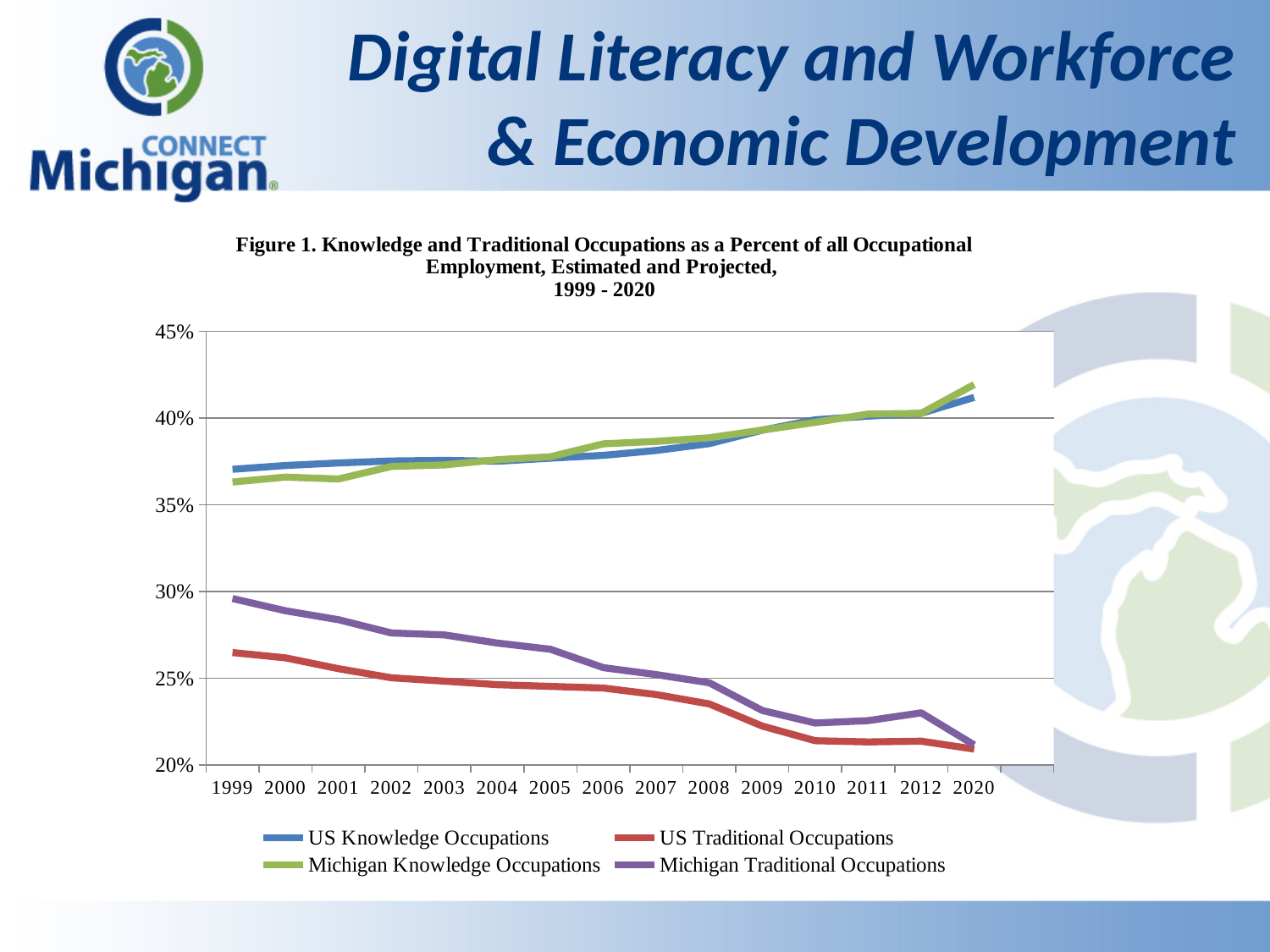
How many years are labelled along the x axis? 15 Is the value for US Knowledge Occupations in 2020 greater or less than 40%? greater How many series does the legend list? 4 Is the value for Michigan Traditional Occupations in 1999 greater or less than 25%? greater Do the values for US Knowledge Occupations rise or fall from 1999 to 2020? Rise What colour is the line for US Traditional Occupations? Red What kind of chart is shown on the slide? Line chart In 1999, which is larger: Michigan Traditional Occupations or US Traditional Occupations? Michigan Traditional Occupations Do the values for Michigan Traditional Occupations rise or fall from 1999 to 2020? Fall Is the value for Michigan Knowledge Occupations in 1999 greater or less than 40%? less Which series has the lowest value in 1999? US Traditional Occupations